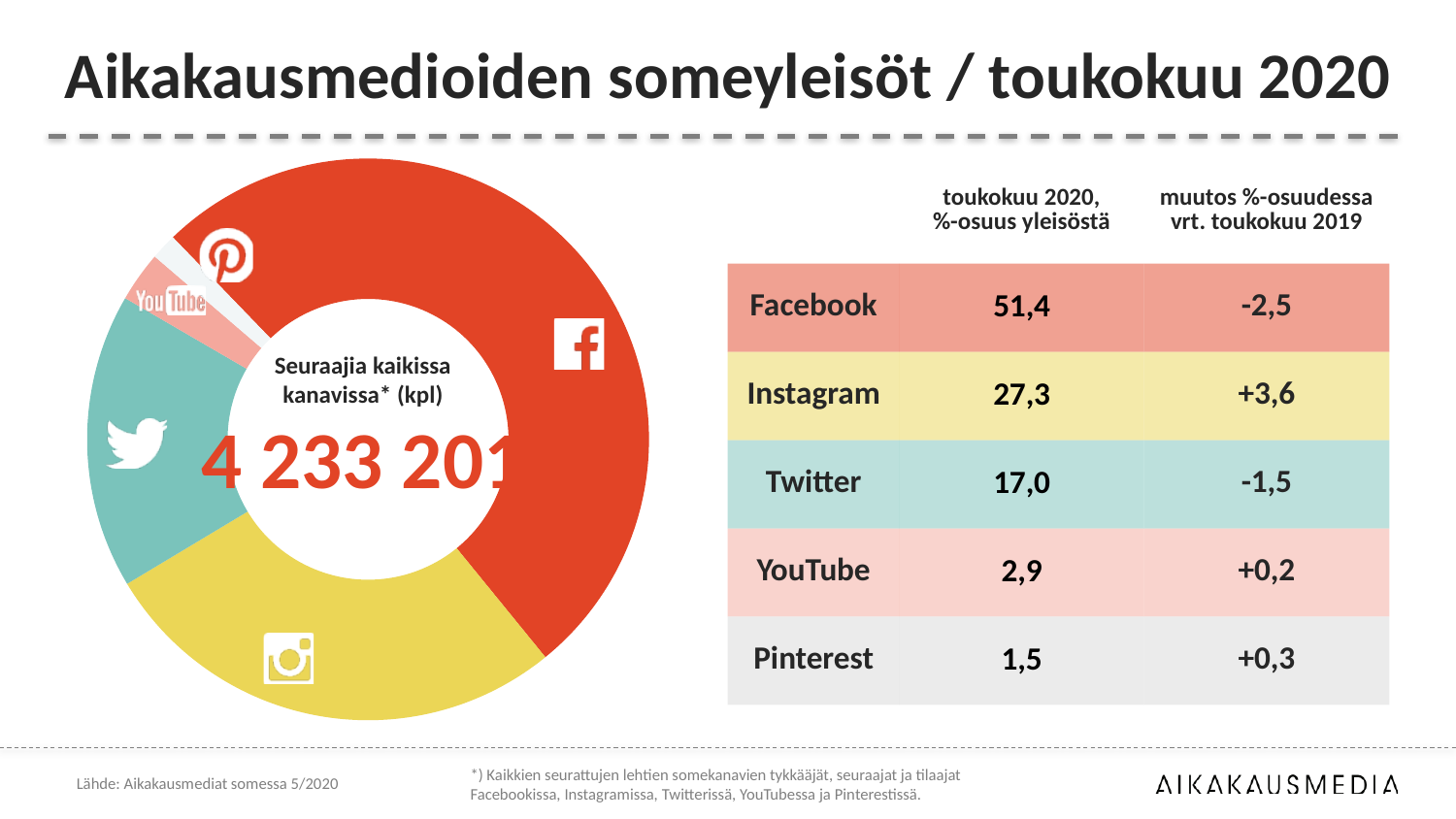
What is the change in percentage share for Facebook compared with May 2019? -2,5 Which slice is larger in the donut chart, Twitter or Instagram? Instagram What is the title of the slide? Aikakausmedioiden someyleisöt / toukokuu 2020 According to the table, what is Facebook's share of the audience in May 2020 (toukokuu 2020, %-osuus yleisöstä)? 51,4 Which channel has the largest slice of the donut chart? Facebook What is the change in percentage share for Instagram compared with May 2019 (muutos %-osuudessa vrt. toukokuu 2019)? +3,6 Which channel has the smallest slice of the donut chart? Pinterest According to the table, what is Instagram's share of the audience in May 2020? 27,3 What is the difference between Facebook's and Instagram's May 2020 audience shares shown in the table? 24,1 How many social media channels are shown as slices in the donut chart? 5 What kind of chart is shown on the left of the slide? Pie (donut) chart According to the table, what is Twitter's share of the audience in May 2020? 17,0